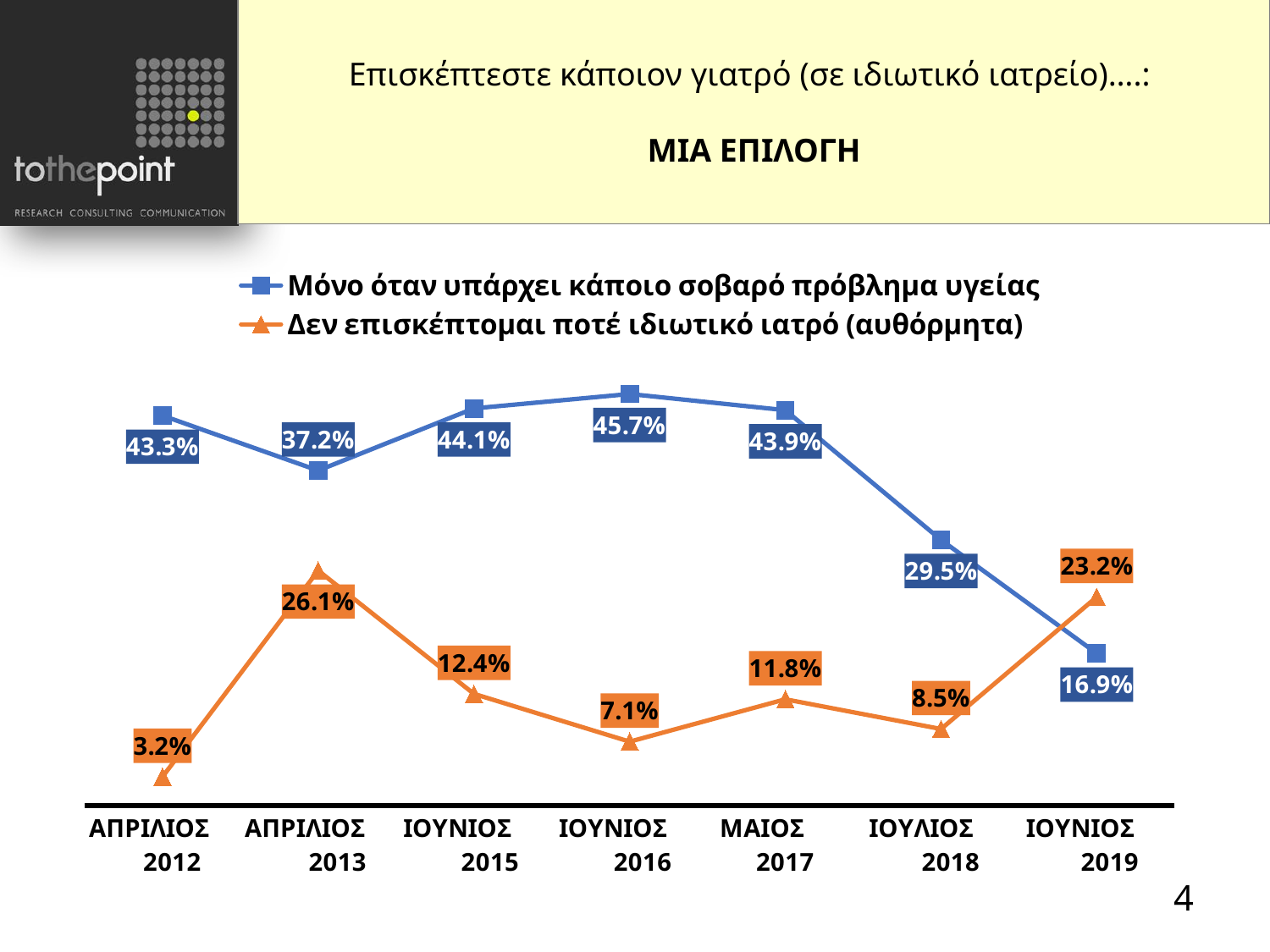
How many time periods are shown on the x axis? 7 Does the series 'Μόνο όταν υπάρχει κάποιο σοβαρό πρόβλημα υγείας' rise or fall from ΜΑΙΟΣ 2017 to ΙΟΥΝΙΟΣ 2019? Fall In which period does the series 'Μόνο όταν υπάρχει κάποιο σοβαρό πρόβλημα υγείας' reach its highest value? ΙΟΥΝΙΟΣ 2016 What colour is the line for the series 'Δεν επισκέπτομαι ποτέ ιδιωτικό ιατρό (αυθόρμητα)'? Orange In which period does the series 'Δεν επισκέπτομαι ποτέ ιδιωτικό ιατρό (αυθόρμητα)' have its lowest value? ΑΠΡΙΛΙΟΣ 2012 What is the value of the series 'Μόνο όταν υπάρχει κάποιο σοβαρό πρόβλημα υγείας' for ΙΟΥΝΙΟΣ 2019? 16.9% What is the difference between the two series in ΙΟΥΝΙΟΣ 2019? 6.3% What is the value of the series 'Δεν επισκέπτομαι ποτέ ιδιωτικό ιατρό (αυθόρμητα)' for ΑΠΡΙΛΙΟΣ 2013? 26.1% What kind of chart is shown on the slide? Line chart How many series does the legend list? 2 What is the value of the series 'Μόνο όταν υπάρχει κάποιο σοβαρό πρόβλημα υγείας' for ΙΟΥΝΙΟΣ 2016? 45.7% Which series has the higher value in ΙΟΥΝΙΟΣ 2019? Δεν επισκέπτομαι ποτέ ιδιωτικό ιατρό (αυθόρμητα)